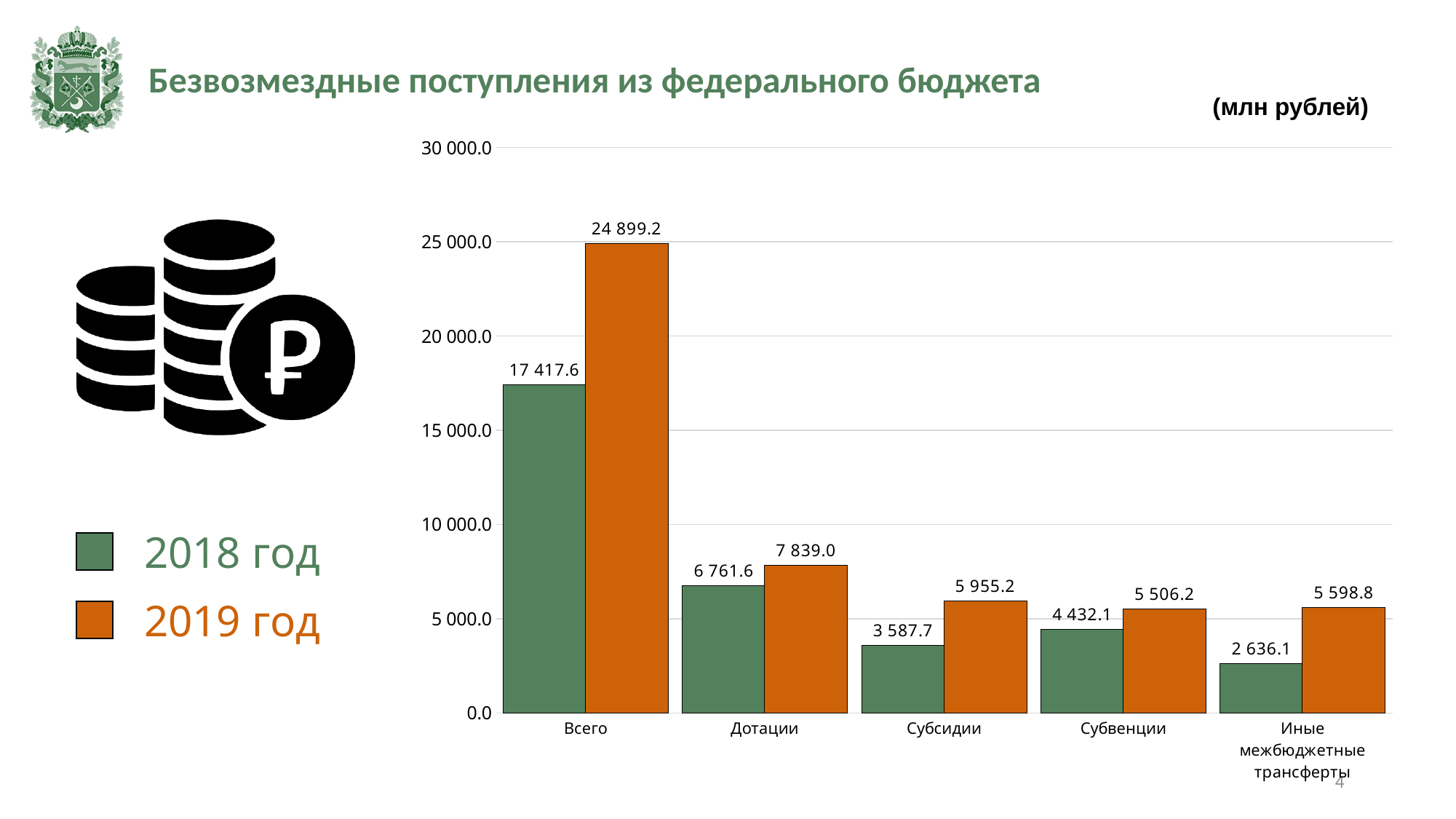
Which is larger: Субвенции in 2018 год or Субсидии in 2018 год? Субвенции in 2018 год What is the difference between the 2019 год and 2018 год values for Всего? 7 481.6 How many categories are shown on the x axis? 5 Excluding Всего, which category has the highest value in 2019 год? Дотации Is the value for Дотации in 2019 год greater or less than 5 000.0? greater Which category has the lowest value in 2018 год? Иные межбюджетные трансферты What kind of chart is shown on the slide? bar chart What is the value for Иные межбюджетные трансферты in 2018 год? 2 636.1 What is the value for Всего in 2018 год? 17 417.6 How many series does the legend list? 2 What is the value for Субсидии in 2019 год? 5 955.2 What is the difference between the 2019 год and 2018 год values for Субсидии? 2 367.5